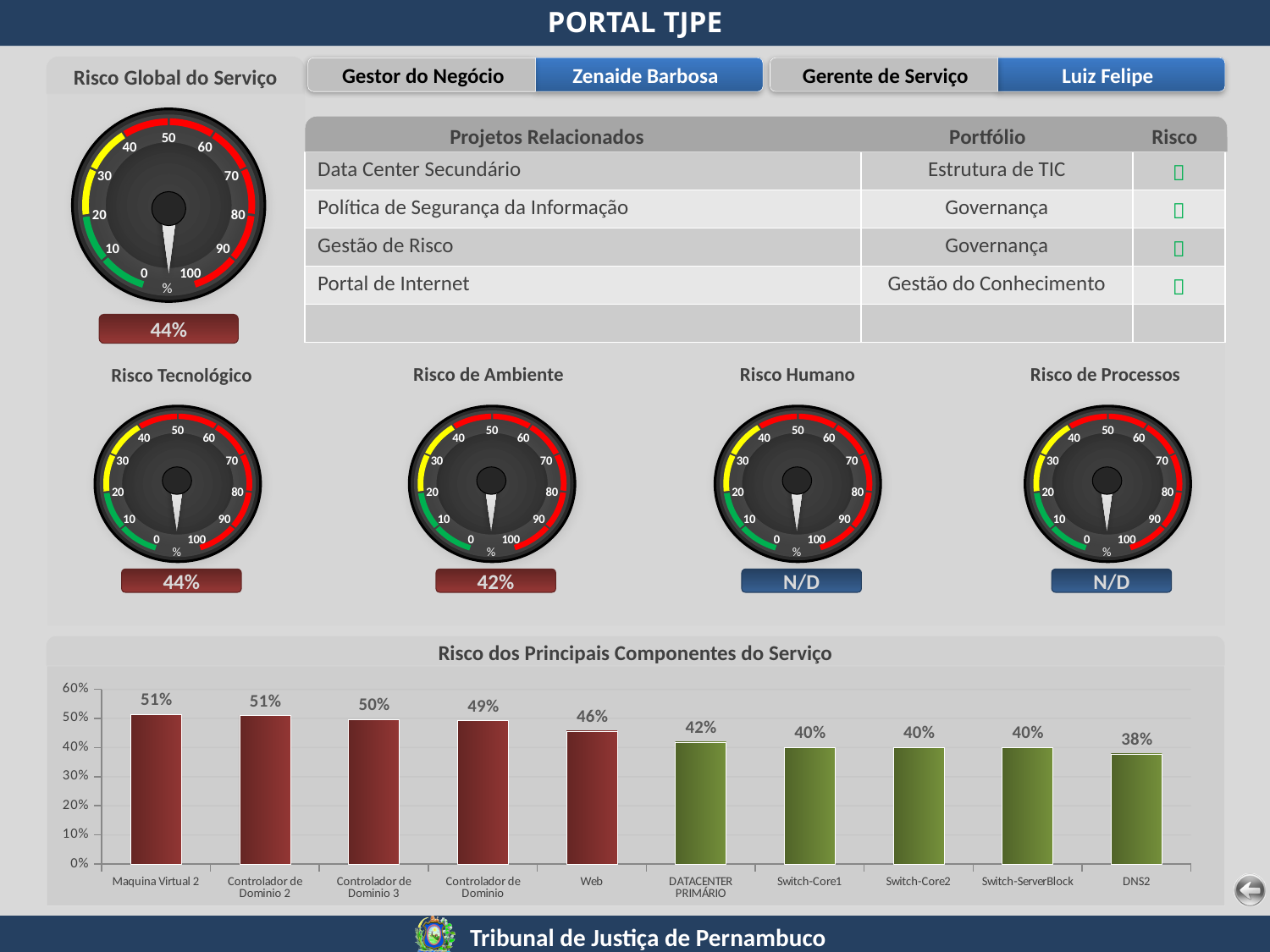
In the 'Risco dos Principais Componentes do Serviço' chart, do the values rise or fall from left to right? Fall In the 'Risco dos Principais Componentes do Serviço' chart, what is the value for DATACENTER PRIMÁRIO? 42% In the 'Risco dos Principais Componentes do Serviço' chart, is the value for Switch-Core2 greater or less than 50%? less In the 'Risco dos Principais Componentes do Serviço' chart, which is larger, Web or Switch-Core1? Web In the 'Risco dos Principais Componentes do Serviço' chart, what is the value for Controlador de Dominio 3? 50% In the 'Risco dos Principais Componentes do Serviço' chart, what is the value for Web? 46% What kind of chart is 'Risco dos Principais Componentes do Serviço'? Bar chart What value is shown below the 'Risco de Ambiente' gauge? 42% In the 'Risco dos Principais Componentes do Serviço' chart, what is the difference between Maquina Virtual 2 and DNS2? 13% In the 'Risco dos Principais Componentes do Serviço' chart, which component has the lowest value? DNS2 What value is shown below the 'Risco Humano' gauge? N/D In the 'Risco dos Principais Componentes do Serviço' chart, how many components are plotted? 10